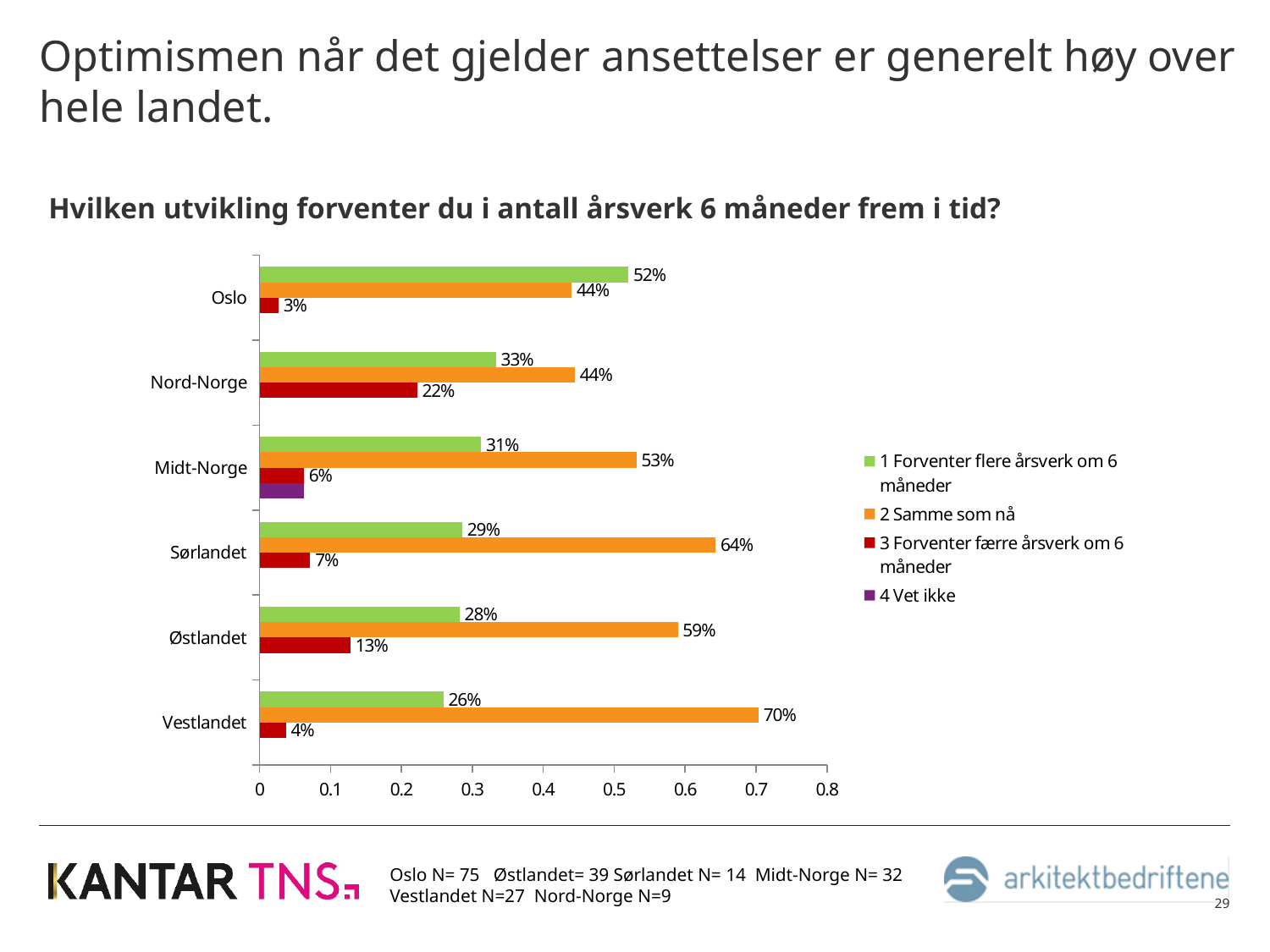
What is the value of "2 Samme som nå" for Vestlandet? 70% How many regions are shown on the chart? 6 What is the value of "3 Forventer færre årsverk om 6 måneder" for Nord-Norge? 22% Which region has the highest value for "3 Forventer færre årsverk om 6 måneder"? Nord-Norge What percentage of respondents in Oslo expect more full-time equivalents ("1 Forventer flere årsverk om 6 måneder")? 52% What type of chart is shown on the slide? Bar chart What is the difference between the "2 Samme som nå" values for Sørlandet and Østlandet? 5% Which is larger for Oslo: "1 Forventer flere årsverk om 6 måneder" or "2 Samme som nå"? 1 Forventer flere årsverk om 6 måneder Which region has the lowest value for "1 Forventer flere årsverk om 6 måneder"? Vestlandet Which region has the highest value for "2 Samme som nå"? Vestlandet How many series does the legend list? 4 What is the value of "3 Forventer færre årsverk om 6 måneder" for Østlandet? 13%